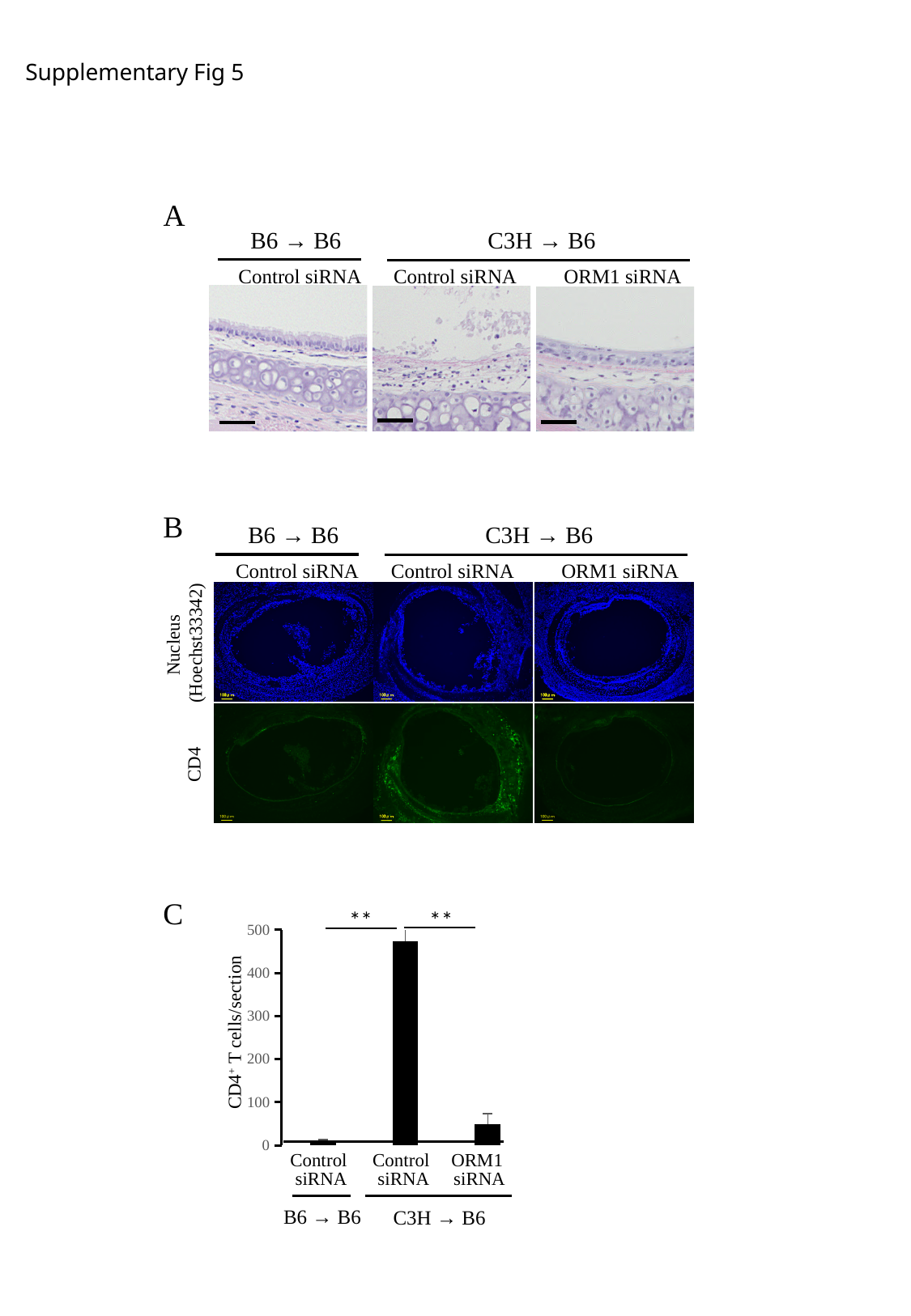
In panel C, how many bars are plotted? 3 In panel C, is the value for C3H → B6 ORM1 siRNA greater or less than 100? less In panel C, which bar is the highest? C3H → B6 Control siRNA In panel C, is the value for B6 → B6 Control siRNA greater or less than 100? less In panel C, which bar is the lowest? B6 → B6 Control siRNA In panel C, what is the highest value shown on the y axis? 500 In panel C, what kind of chart is shown? bar chart In panel C, what is the label of the y axis? CD4+ T cells/section In panel C, which is larger: the value for C3H → B6 ORM1 siRNA or B6 → B6 Control siRNA? C3H → B6 ORM1 siRNA In panel C, which is larger: the value for C3H → B6 Control siRNA or C3H → B6 ORM1 siRNA? C3H → B6 Control siRNA In panel C, is the value for C3H → B6 Control siRNA greater or less than 400? greater